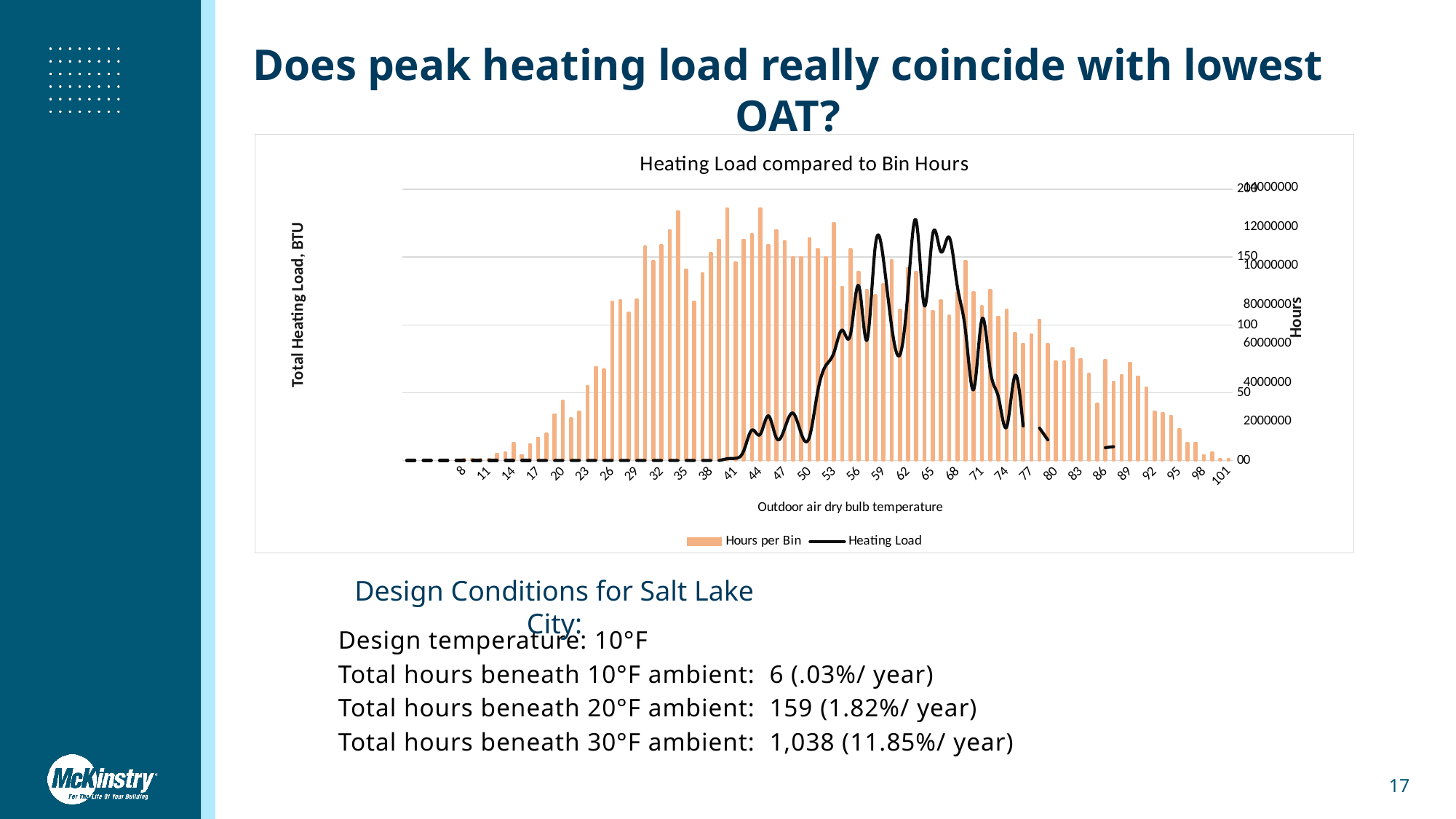
How many series does the chart legend list? 2 Do the Hours per Bin values generally rise or fall as the outdoor air dry bulb temperature increases from 71 to 101? fall Which has the larger Hours per Bin value: an outdoor air dry bulb temperature of 44 or 95? 44 Which series is drawn as a black line in the chart? Heating Load Is the Hours per Bin value at an outdoor air dry bulb temperature of 20 greater or less than 50? less Is the Hours per Bin value at an outdoor air dry bulb temperature of 101 greater or less than 50? less What is the title of the chart? Heating Load compared to Bin Hours What kind of chart is shown on the slide? Combination bar and line chart Is the Hours per Bin value at an outdoor air dry bulb temperature of 44 greater or less than 150? greater